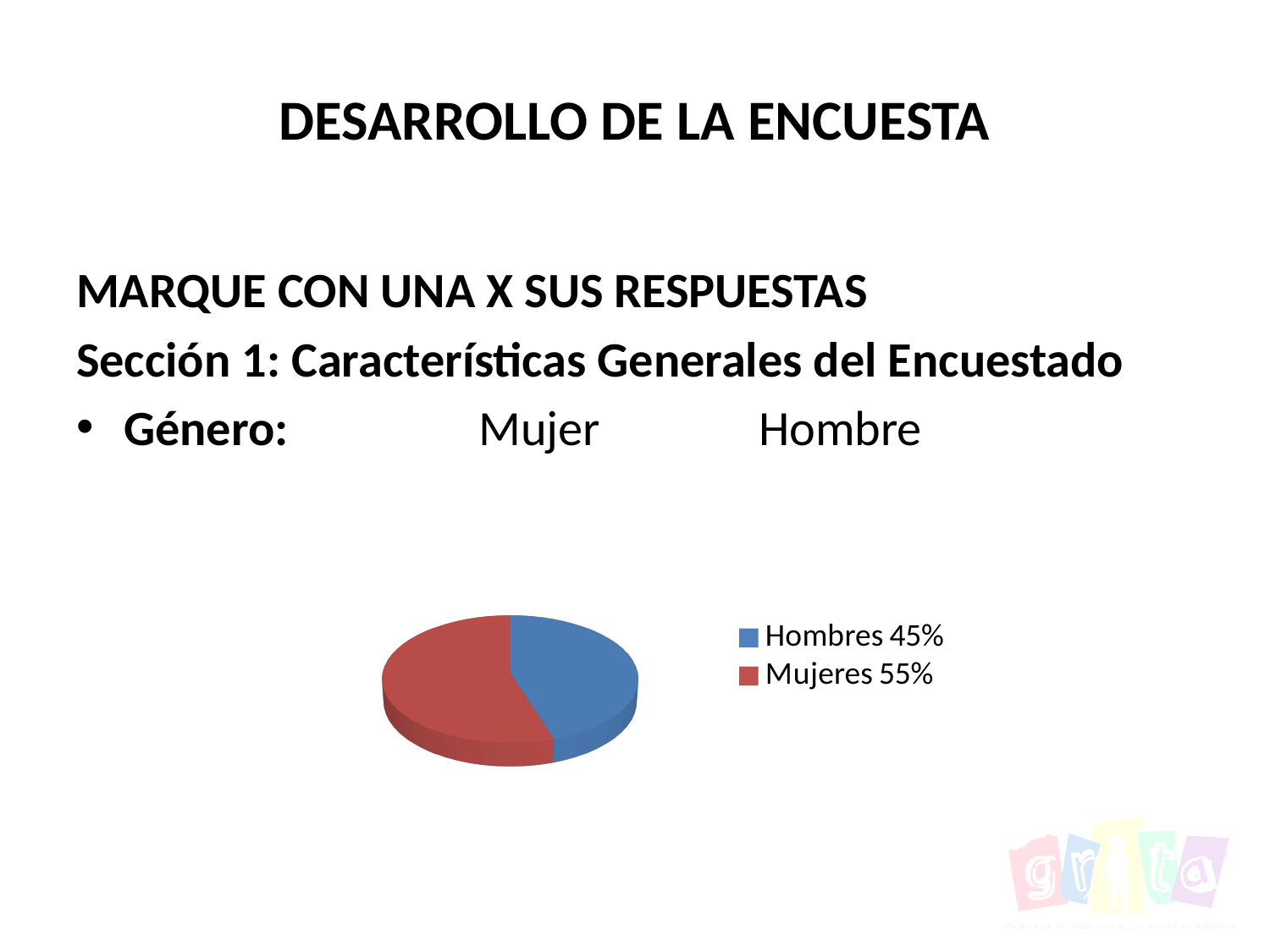
How many slices does the pie chart have? 2 What is the difference between the Mujeres share and the Hombres share? 10% What kind of chart is shown on the slide? pie chart What share of the pie is labelled for Mujeres? 55% What colour is the Mujeres slice? red Is the Hombres share greater or less than 50%? less What colour is the Hombres slice? blue How many entries does the legend list? 2 Which slice of the pie is the smallest? Hombres 45% Which slice of the pie is the largest? Mujeres 55% What share of the pie is labelled for Hombres? 45% Which is larger, the Hombres share or the Mujeres share? Mujeres